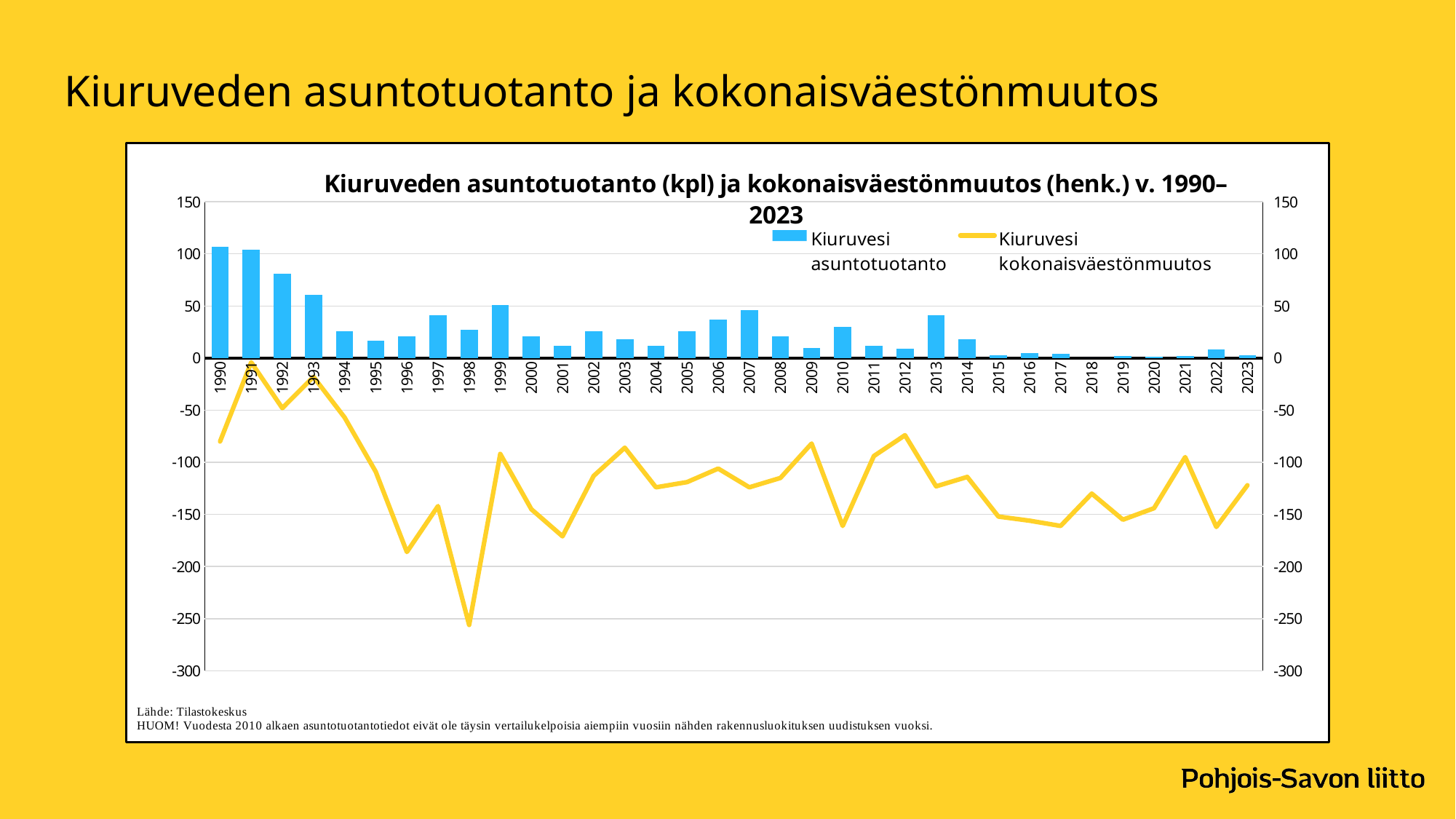
Is the Kiuruvesi asuntotuotanto bar for 1992 greater or less than 50? greater What kind of chart is shown on the slide? A combined bar and line chart Is the Kiuruvesi asuntotuotanto bar for 1990 greater or less than 100? greater In which year is the Kiuruvesi kokonaisväestönmuutos line at its lowest? 1998 How many years are plotted along the x axis? 34 Which year has the larger Kiuruvesi asuntotuotanto bar, 1999 or 2000? 1999 Do the Kiuruvesi asuntotuotanto bars generally rise or fall from 1990 to 2023? fall How many series does the legend list? 2 Is the Kiuruvesi asuntotuotanto bar for 2013 greater or less than 50? less Which year has the higher Kiuruvesi kokonaisväestönmuutos value, 1998 or 1999? 1999